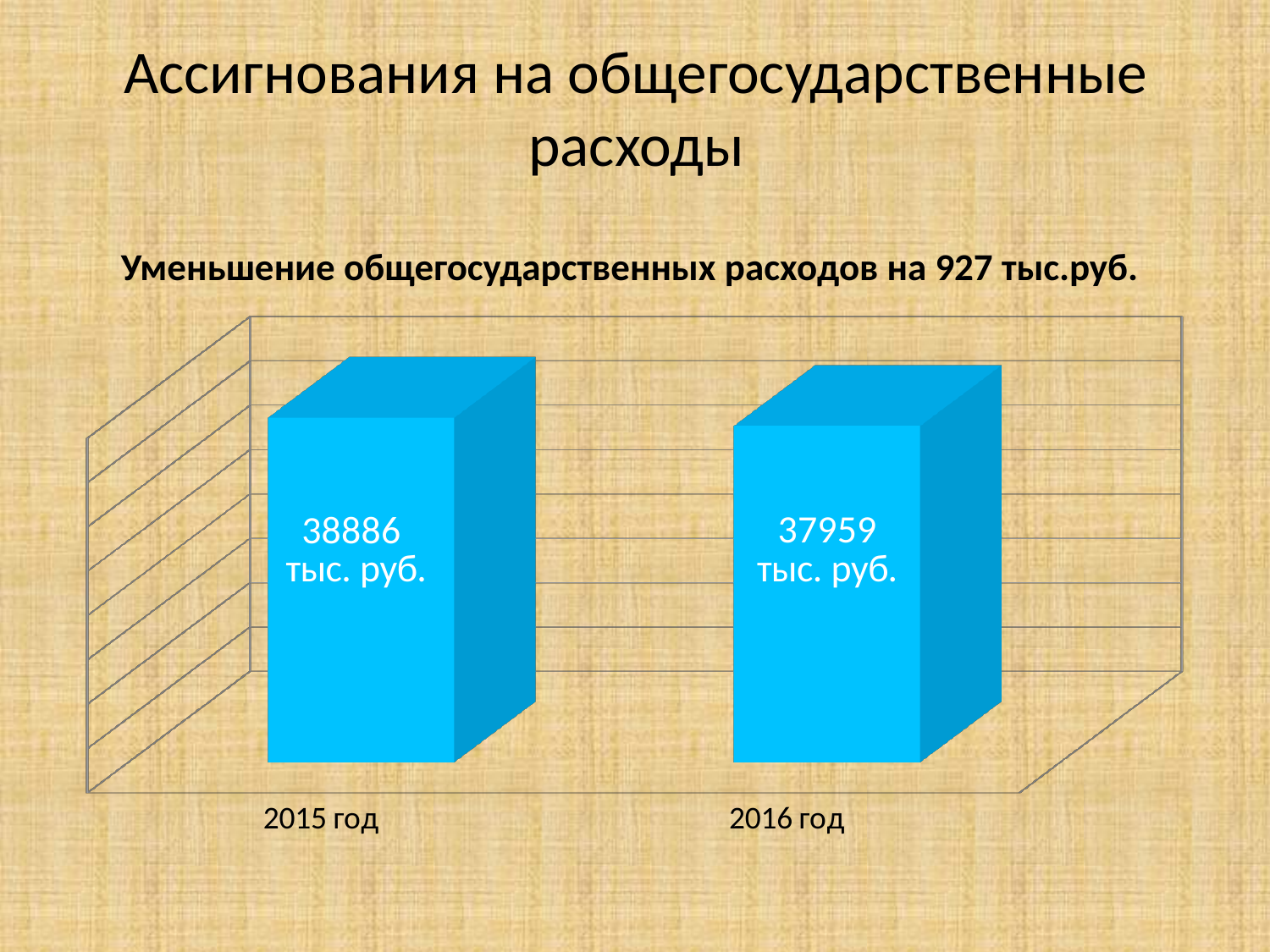
Which is larger, the value for 2015 год or for 2016 год? 2015 год What kind of chart is shown on the slide? bar chart What is the difference between the values for 2015 год and 2016 год? 927 тыс. руб. What is the title of the slide? Ассигнования на общегосударственные расходы How many categories are shown in the chart? 2 What colour are the bars in the chart? blue Which year has the lowest value? 2016 год Do the values rise or fall from 2015 год to 2016 год? fall Which year has the highest value? 2015 год What is the value for 2016 год? 37959 тыс. руб. What is the value for 2015 год? 38886 тыс. руб.